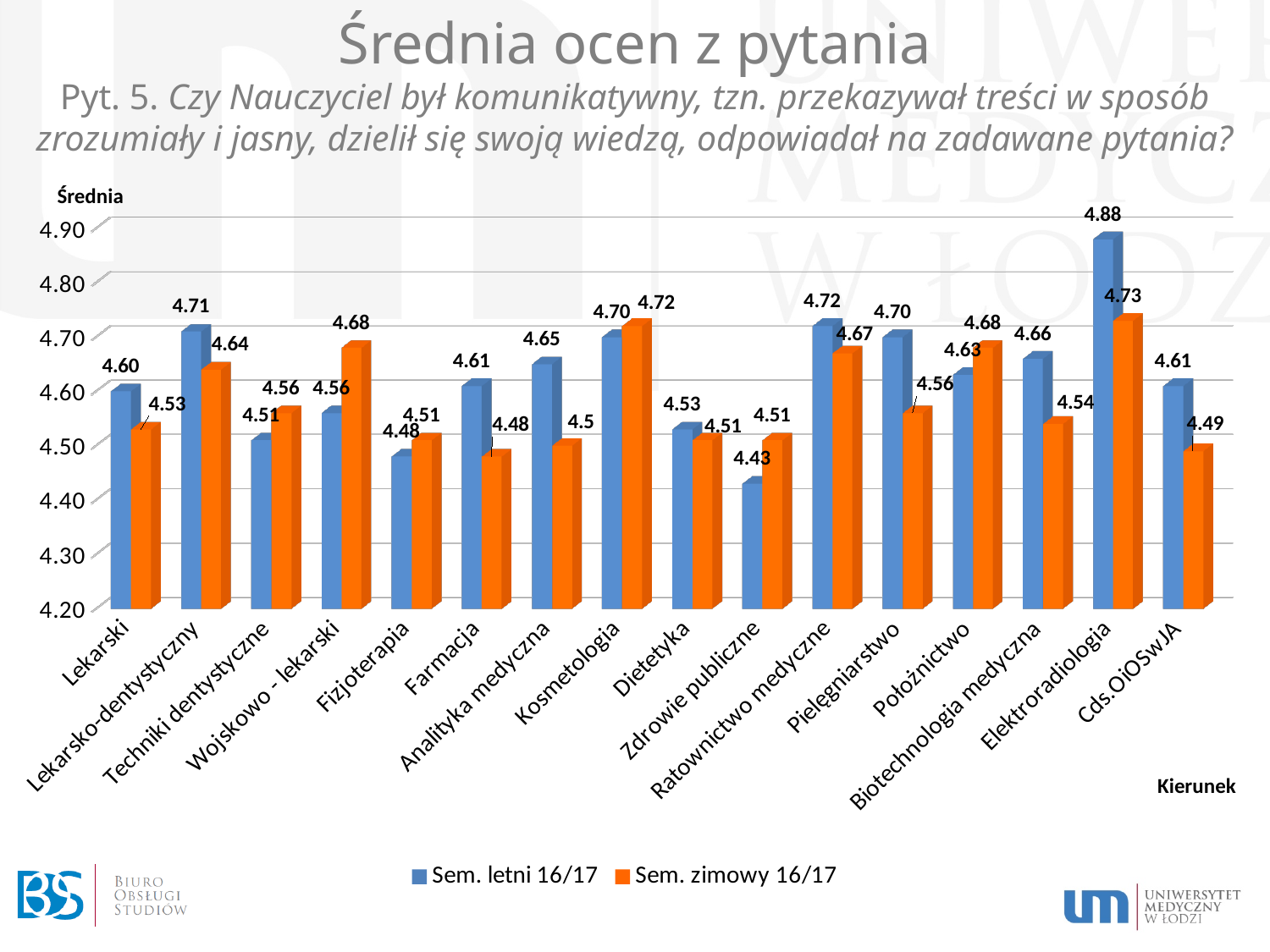
What is the Sem. letni 16/17 value for Elektroradiologia? 4.88 Which is larger for Kosmetologia: the Sem. letni 16/17 value or the Sem. zimowy 16/17 value? Sem. zimowy 16/17 What kind of chart is shown on the slide? bar chart Which category has the lowest Sem. letni 16/17 value? Zdrowie publiczne What is the Sem. zimowy 16/17 value for Wojskowo - lekarski? 4.68 Which category has the highest Sem. letni 16/17 value? Elektroradiologia What is the Sem. zimowy 16/17 value for Analityka medyczna? 4.5 Which category has the lowest Sem. zimowy 16/17 value? Farmacja How many categories (kierunki) are shown on the x axis? 16 What is the difference between the Sem. letni 16/17 and Sem. zimowy 16/17 values for Pielęgniarstwo? 0.14 How many series does the legend list? 2 Is the Sem. letni 16/17 value for Zdrowie publiczne greater or less than 4.50? less